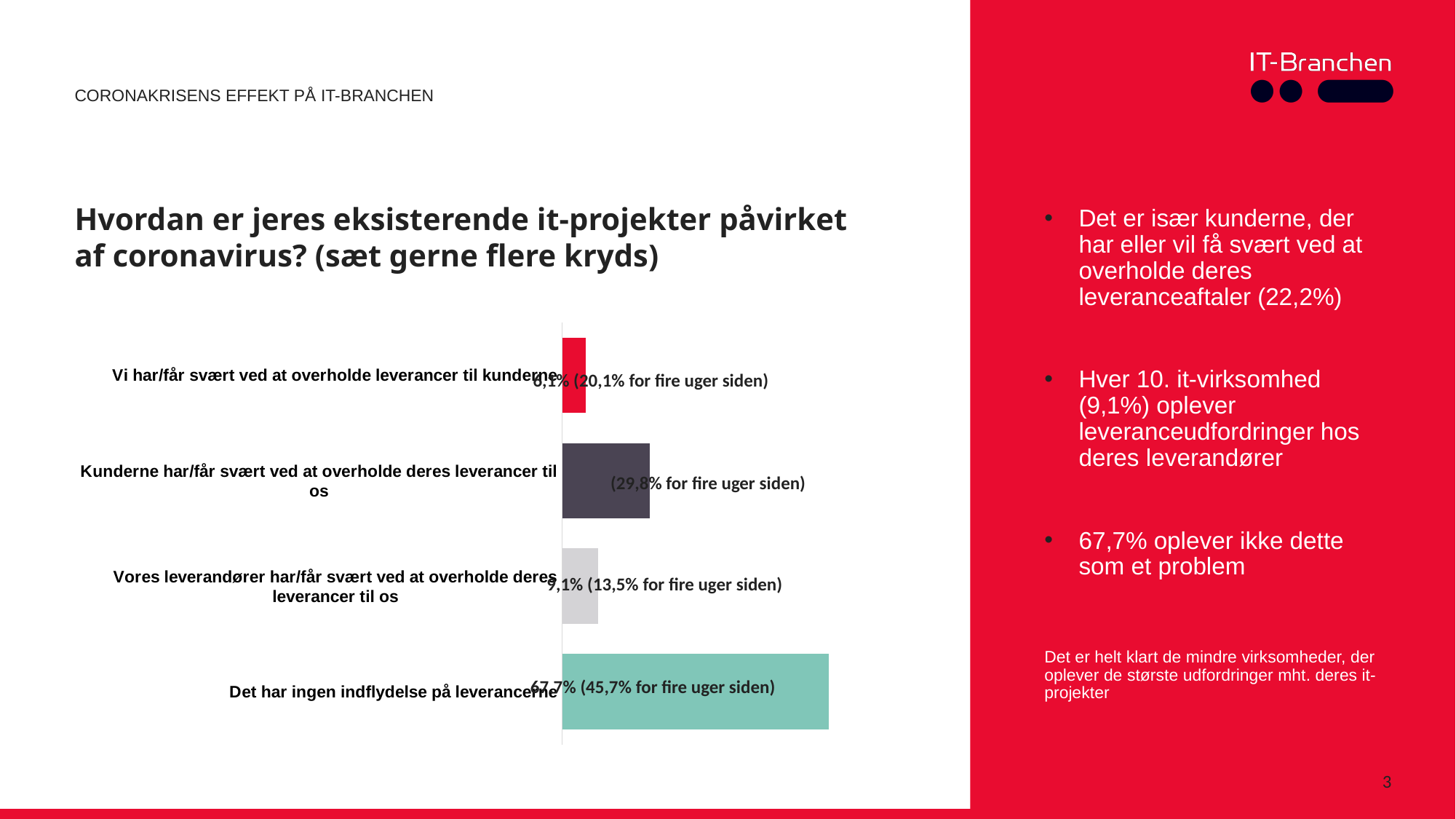
How many categories does the chart show? 4 Which category has the highest value in the chart? Det har ingen indflydelse på leverancerne What kind of chart is shown on the slide? Bar chart What is the difference between the value for 'Det har ingen indflydelse på leverancerne' (67,7%) and the value for 'Vores leverandører har/får svært ved at overholde deres leverancer til os' (9,1%)? 58,6% According to the data label, what was the value for 'Kunderne har/får svært ved at overholde deres leverancer til os' four weeks ago ('for fire uger siden')? 29,8% According to the data label, what was the value for 'Vores leverandører har/får svært ved at overholde deres leverancer til os' four weeks ago ('for fire uger siden')? 13,5% Which bar is longer: 'Kunderne har/får svært ved at overholde deres leverancer til os' or 'Vores leverandører har/får svært ved at overholde deres leverancer til os'? Kunderne har/får svært ved at overholde deres leverancer til os What is the value for 'Vores leverandører har/får svært ved at overholde deres leverancer til os'? 9,1% What colour is the bar for 'Det har ingen indflydelse på leverancerne'? Teal/green What is the value for 'Det har ingen indflydelse på leverancerne'? 67,7% According to the data label, what was the value for 'Det har ingen indflydelse på leverancerne' four weeks ago ('for fire uger siden')? 45,7% Which category has the lowest value in the chart? Vi har/får svært ved at overholde leverancer til kunderne